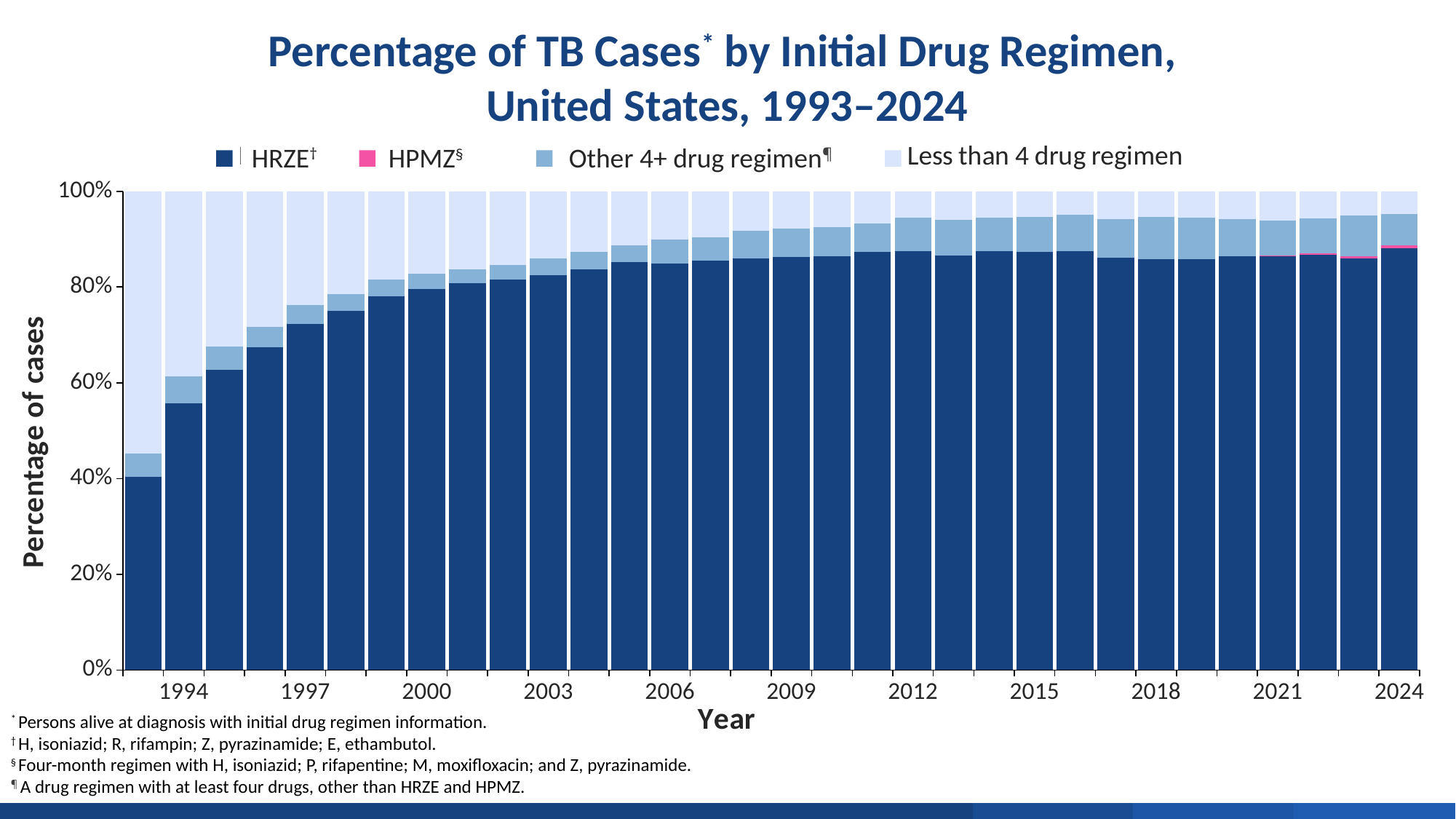
Which series is represented by the pink colour in the legend? HPMZ What is the label of the y axis? Percentage of cases In which year is the HRZE share of cases lowest? 1993 What does each stacked bar total? 100% What kind of chart is shown on the slide? Stacked bar chart Is the HRZE value for 1994 greater or less than 60%? less How many years (bars) are plotted on the chart? 32 Does the HRZE share of cases rise or fall from 1993 to 2024? Rise Is the HRZE value for 2024 greater or less than 80%? greater Which year has the larger HRZE share, 1994 or 1997? 1997 How many series does the legend list? 4 Is the HRZE value for 1993 greater or less than 60%? less